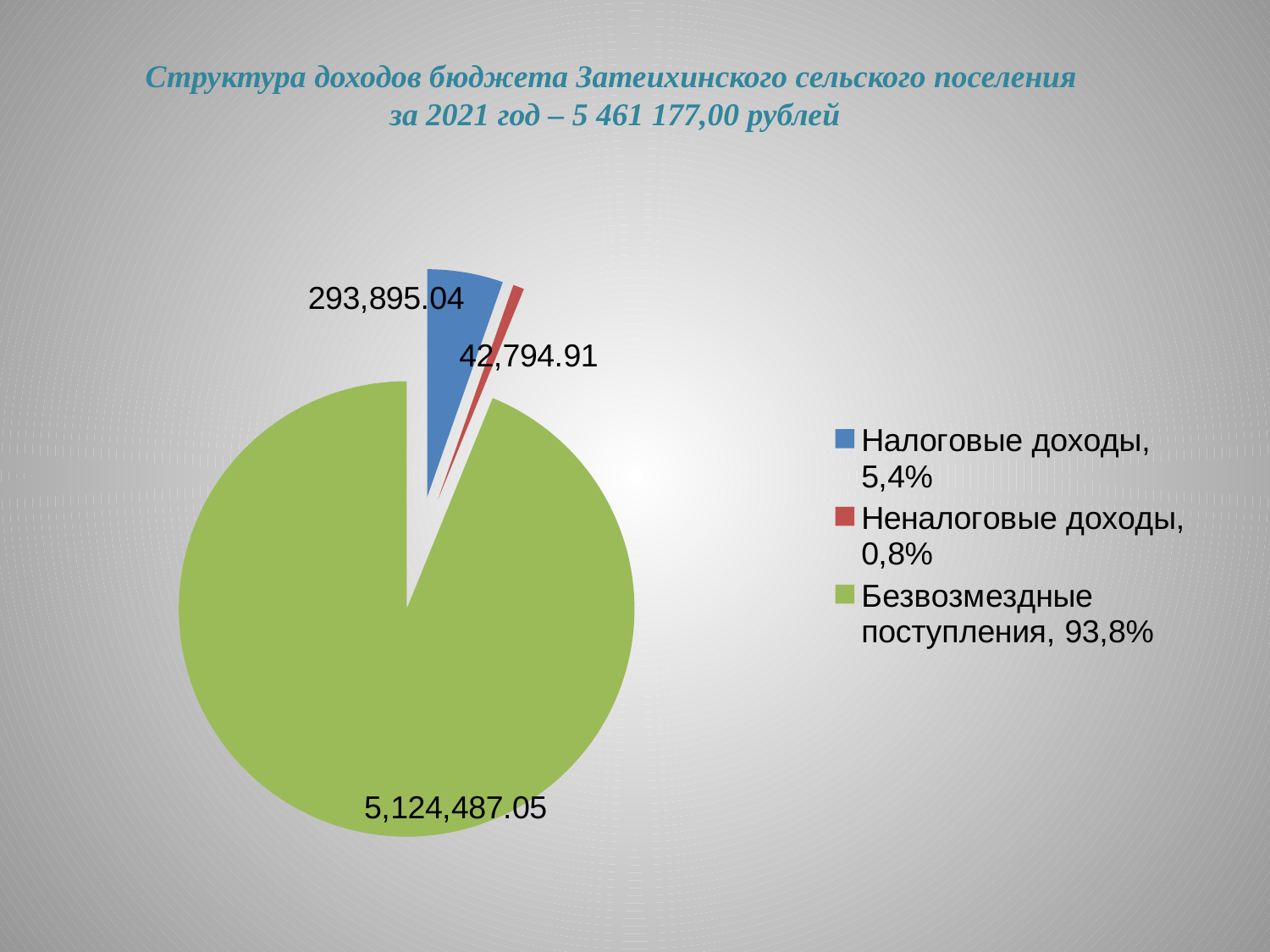
What type of chart is shown on the slide? pie chart Which category has the largest slice of the pie? Безвозмездные поступления What is the value for Безвозмездные поступления? 5,124,487.05 What share of the pie does Налоговые доходы represent, according to the legend? 5,4% What is the value for Неналоговые доходы? 42,794.91 Which category has the smallest slice of the pie? Неналоговые доходы What is the difference between the values for Налоговые доходы and Неналоговые доходы? 251,100.13 How many slices does the pie chart have? 3 Which is larger, the value for Налоговые доходы or the value for Неналоговые доходы? Налоговые доходы What colour is the slice for Безвозмездные поступления? green What is the value for Налоговые доходы? 293,895.04 What share of the pie does Безвозмездные поступления represent, according to the legend? 93,8%